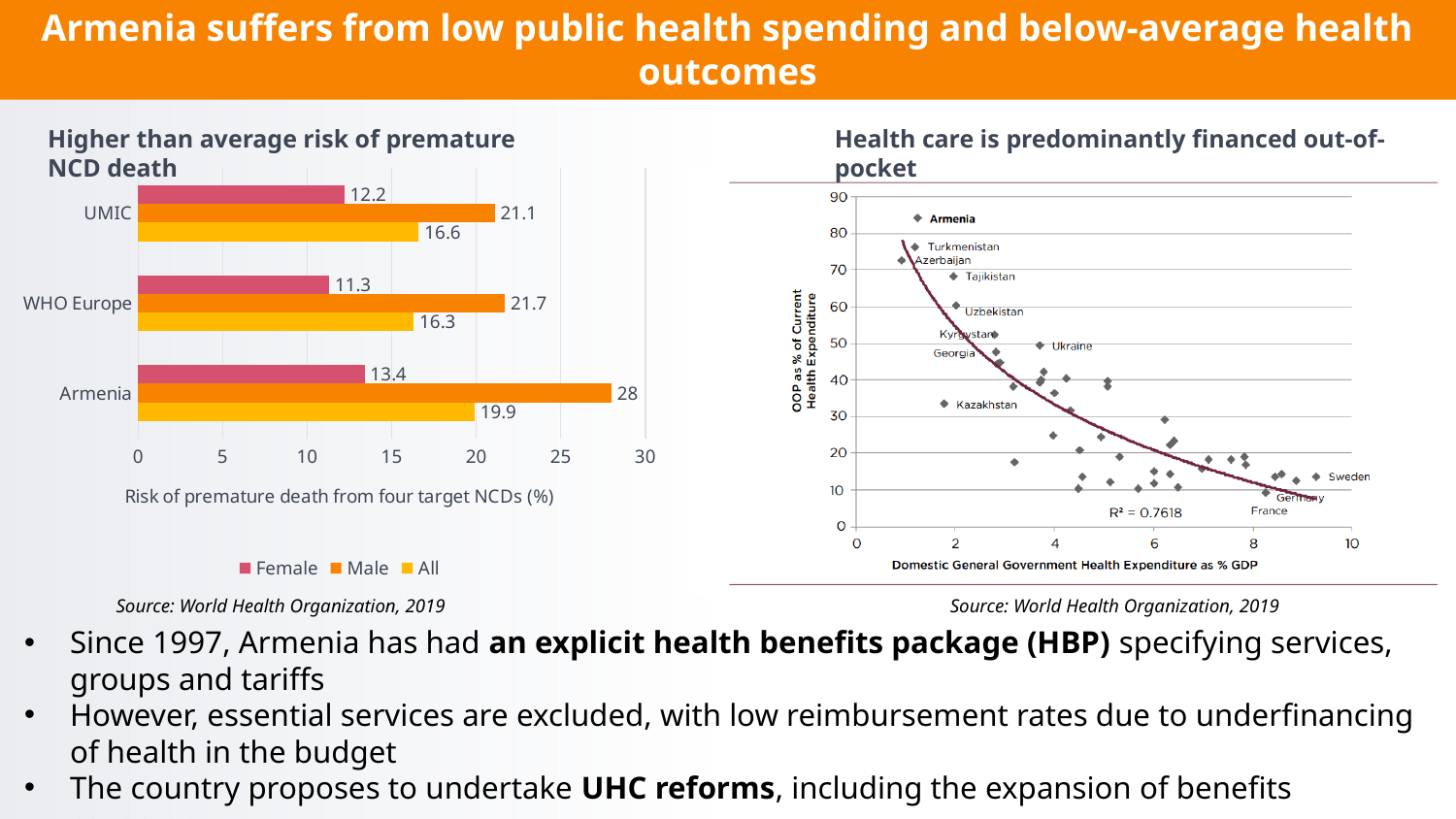
In the chart titled 'Higher than average risk of premature NCD death', is the All value larger for Armenia or for WHO Europe? Armenia In the chart titled 'Higher than average risk of premature NCD death', what is the Female value for WHO Europe? 11.3 In the chart titled 'Higher than average risk of premature NCD death', what is the difference between the Male and Female values for Armenia? 14.6 In the chart titled 'Higher than average risk of premature NCD death', what is the All value for UMIC? 16.6 In the chart titled 'Higher than average risk of premature NCD death', how many series does the legend list? 3 In the chart titled 'Higher than average risk of premature NCD death', how many categories are shown on the vertical axis? 3 In the chart titled 'Higher than average risk of premature NCD death', what is the Male value for Armenia? 28 In the chart titled 'Health care is predominantly financed out-of-pocket', is the OOP value for Armenia greater or less than 80? greater In the chart titled 'Higher than average risk of premature NCD death', which category has the highest Male value? Armenia What kind of chart is the one titled 'Higher than average risk of premature NCD death'? Bar chart In the chart titled 'Higher than average risk of premature NCD death', which category has the lowest Female value? WHO Europe In the chart titled 'Health care is predominantly financed out-of-pocket', what R² value is printed on the chart? R² = 0.7618